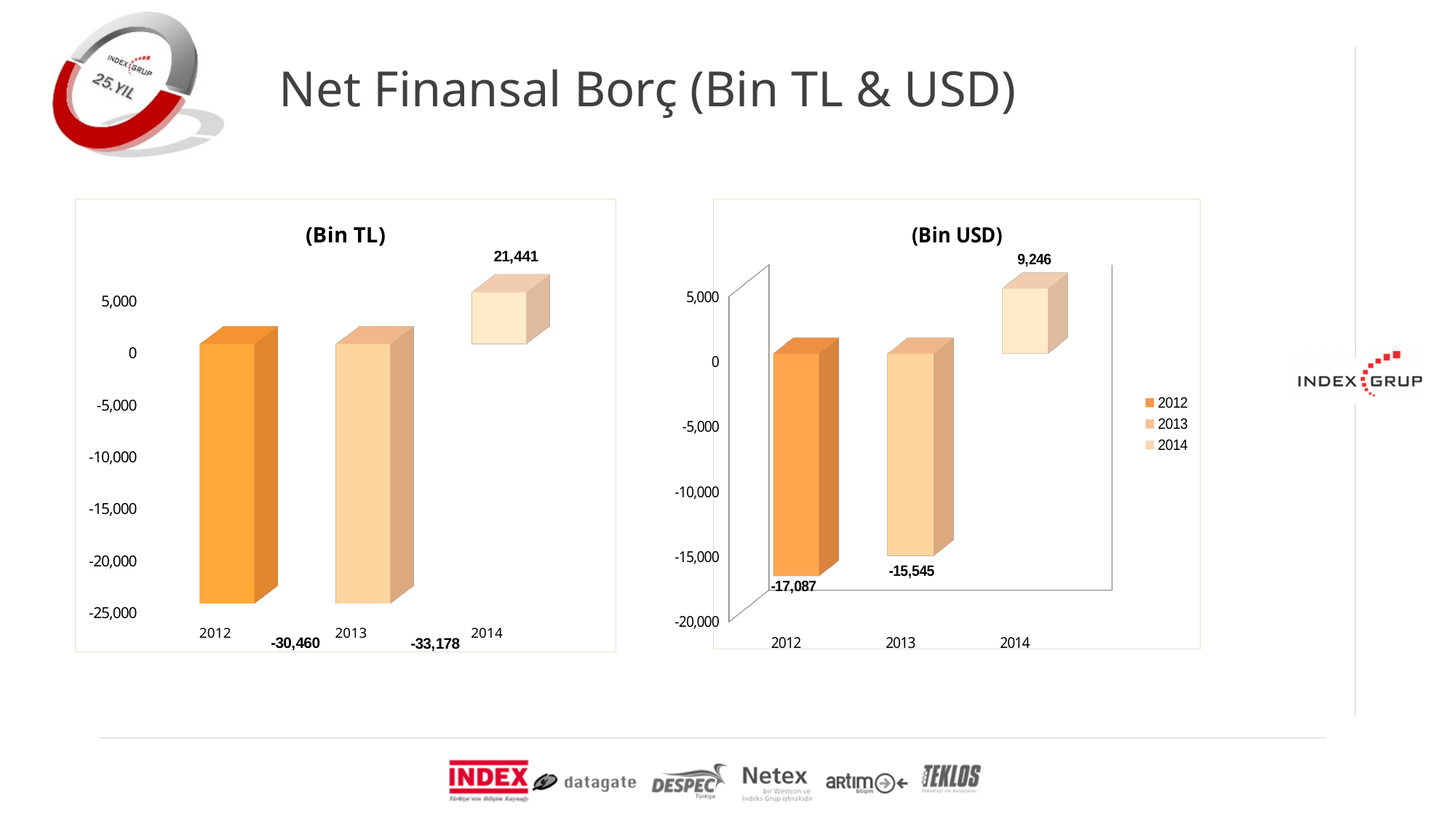
How many years are shown in the (Bin TL) chart? 3 In the (Bin USD) chart, what is the difference between the 2012 value and the 2013 value? 1,542 What kind of chart is the (Bin USD) chart? Bar chart In the (Bin TL) chart, what is the value for 2012? -30,460 In the (Bin USD) chart, what is the value for 2013? -15,545 In the (Bin TL) chart, what is the difference between the 2013 value and the 2012 value? 2,718 In the (Bin USD) chart, what is the value for 2014? 9,246 In the (Bin TL) chart, which year has the lowest value? 2013 In the (Bin USD) chart, which is larger, the value for 2012 or the value for 2013? 2013 In the (Bin TL) chart, what is the value for 2014? 21,441 How many entries does the legend of the (Bin USD) chart list? 3 In the (Bin USD) chart, which year has the highest value? 2014